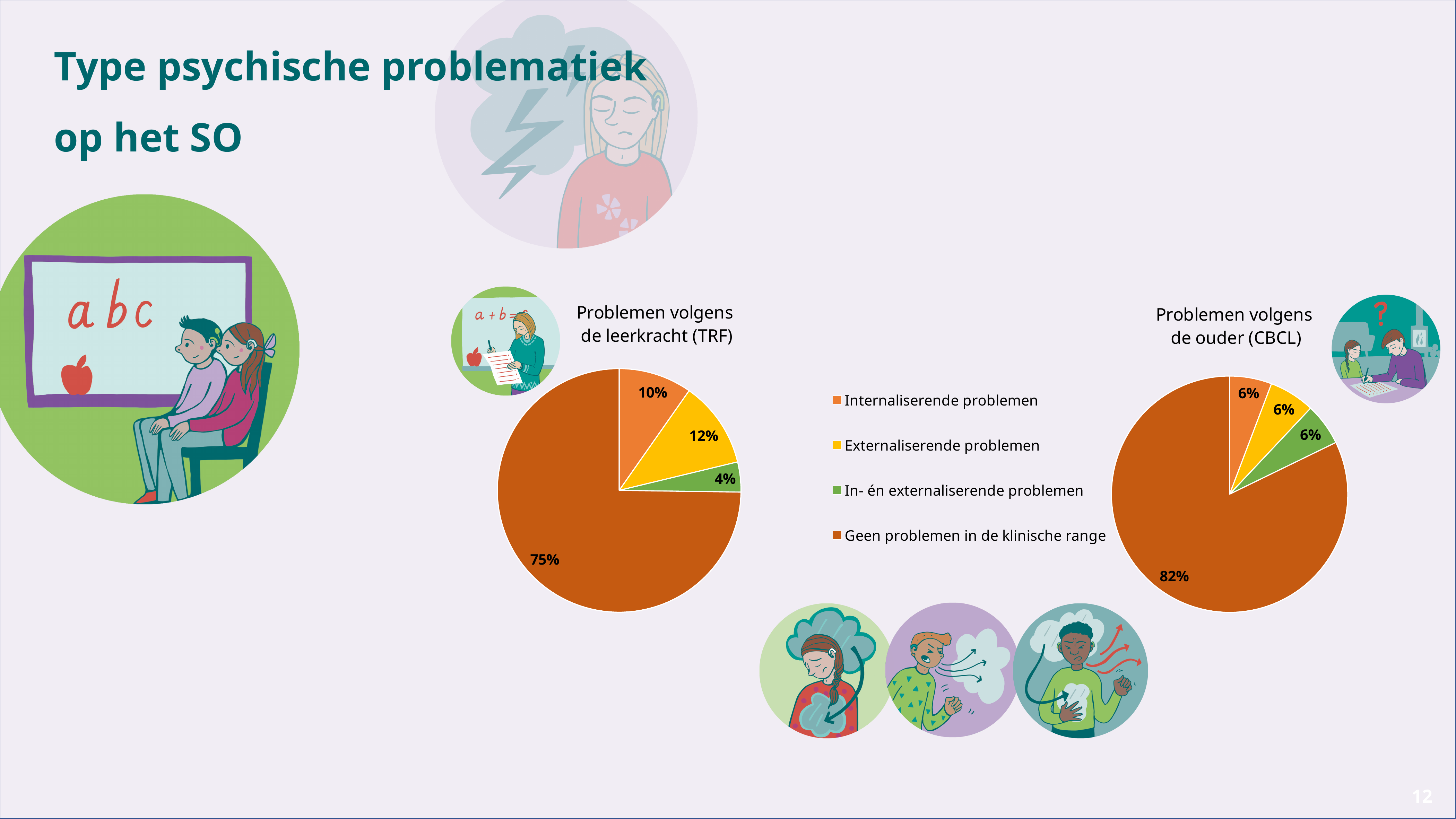
In the 'Problemen volgens de ouder (CBCL)' chart, what share is labelled for Internaliserende problemen? 6% In the 'Problemen volgens de ouder (CBCL)' chart, which category has the largest slice? Geen problemen in de klinische range In the 'Problemen volgens de leerkracht (TRF)' chart, what share is labelled for Internaliserende problemen? 10% What type of chart is 'Problemen volgens de ouder (CBCL)'? Pie chart How many entries does the legend between the two charts list? 4 In the 'Problemen volgens de leerkracht (TRF)' chart, what share is labelled for Geen problemen in de klinische range? 75% Which chart shows a larger share for Geen problemen in de klinische range, the TRF chart or the CBCL chart? The CBCL chart In the 'Problemen volgens de leerkracht (TRF)' chart, what share is labelled for In- én externaliserende problemen? 4% In the 'Problemen volgens de ouder (CBCL)' chart, what share is labelled for Geen problemen in de klinische range? 82% In the 'Problemen volgens de leerkracht (TRF)' chart, what share is labelled for Externaliserende problemen? 12% In the 'Problemen volgens de leerkracht (TRF)' chart, which category has the smallest slice? In- én externaliserende problemen In the 'Problemen volgens de leerkracht (TRF)' chart, what is the difference between the Externaliserende problemen and Internaliserende problemen shares? 2%